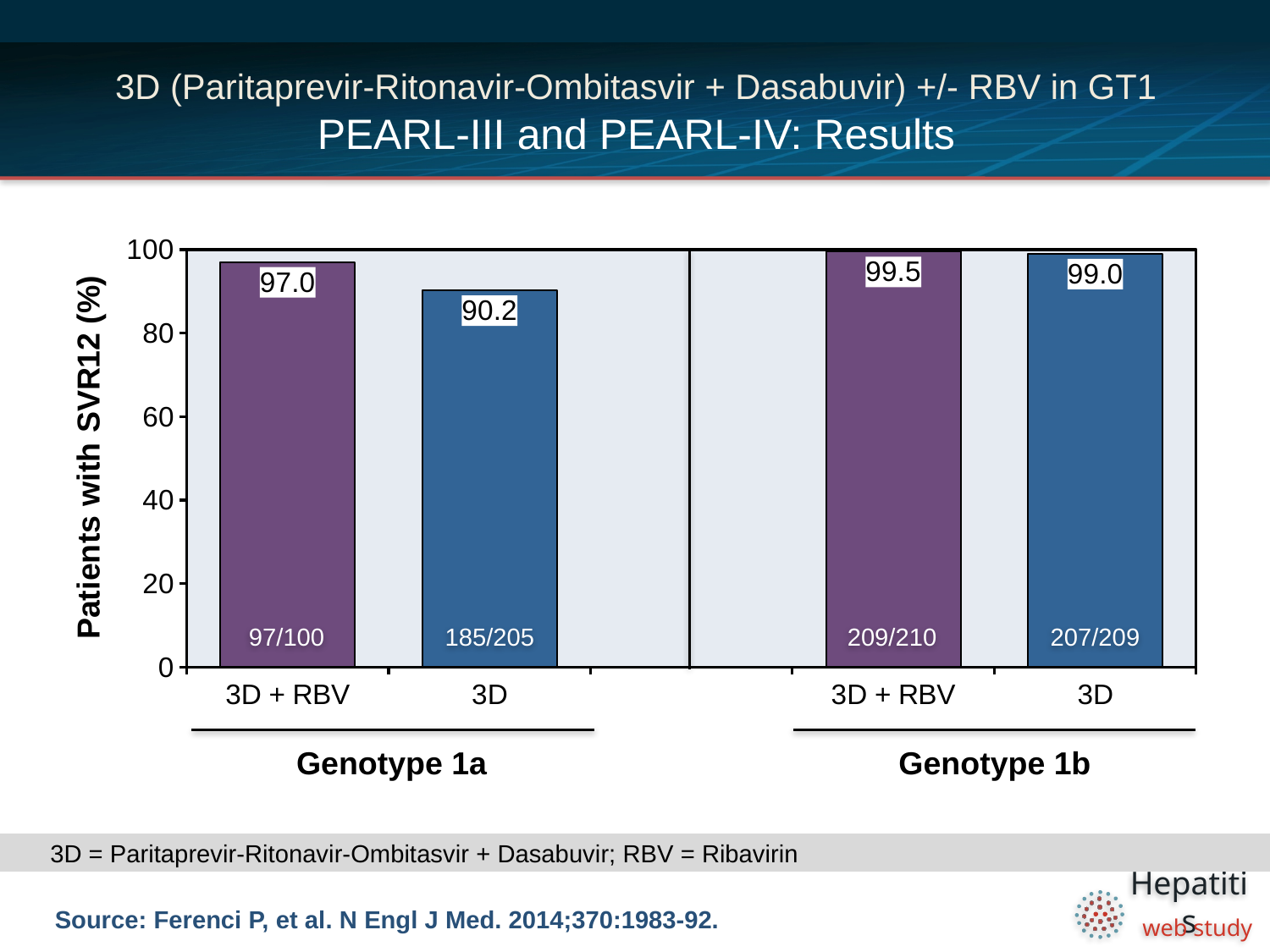
Which bar shows the highest SVR12 rate? 3D + RBV, Genotype 1b What is the difference in SVR12 rate between 3D + RBV and 3D in Genotype 1a? 6.8 What is the patient fraction shown for the 3D group in Genotype 1a? 185/205 What is the SVR12 rate for 3D alone in Genotype 1b? 99.0 Which bar shows the lowest SVR12 rate? 3D, Genotype 1a How many patients achieved SVR12 out of the total in the 3D + RBV Genotype 1b group? 209/210 How many bars are plotted in the chart? 4 What is the SVR12 rate for 3D + RBV in Genotype 1a? 97.0 In Genotype 1b, which regimen has the higher SVR12 rate, 3D + RBV or 3D? 3D + RBV What is the SVR12 rate for 3D alone in Genotype 1a? 90.2 What type of chart is shown on the slide? Bar chart What is the label of the y-axis? Patients with SVR12 (%)